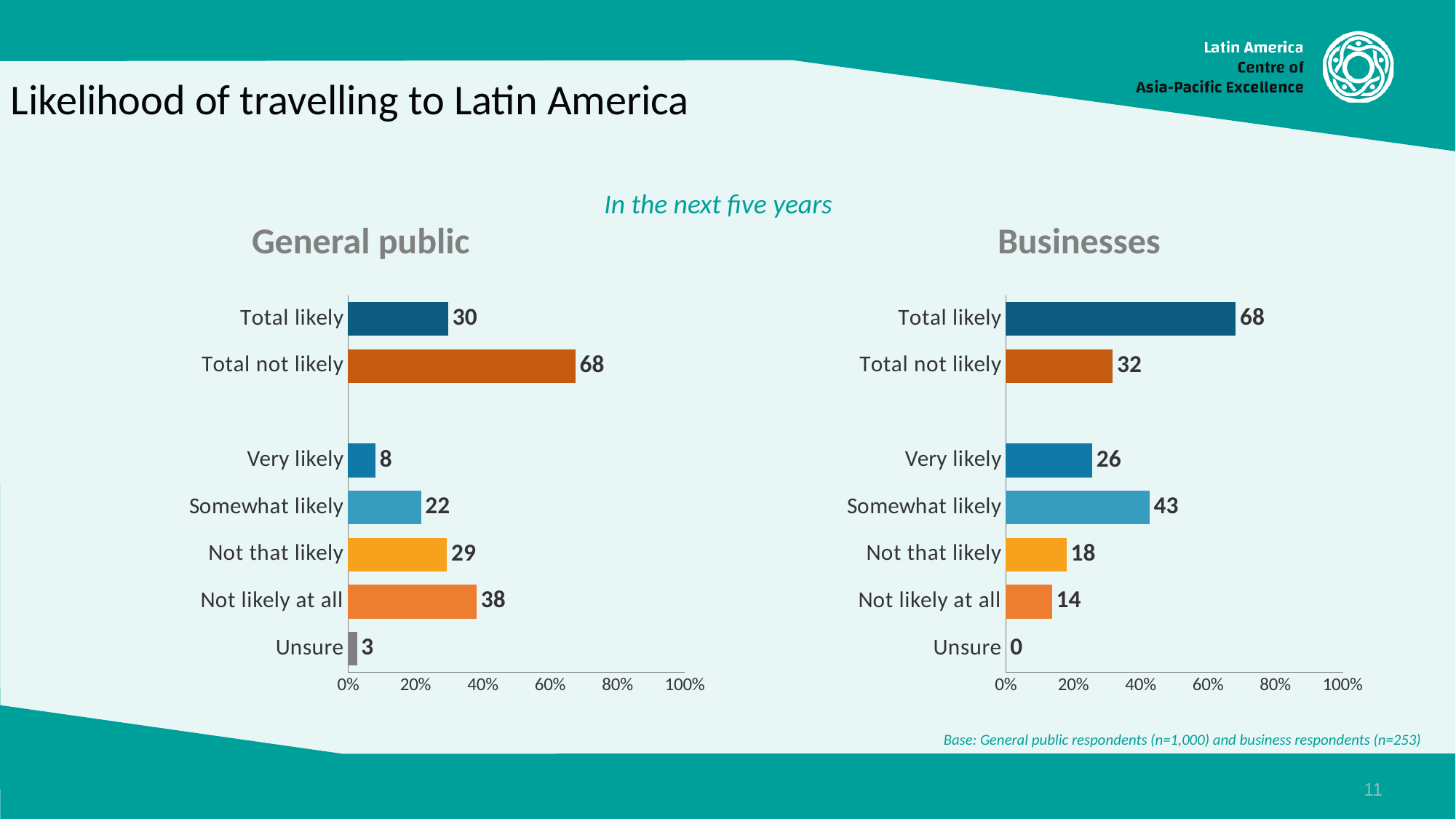
In the General public chart, what is the value for Unsure? 3 What kind of chart is the Businesses chart? Bar chart What is the subtitle shown above the two charts? In the next five years In the Businesses chart, what is the value for Somewhat likely? 43 In the Businesses chart, which category has the highest value? Total likely Which is larger: Very likely in the General public chart or Very likely in the Businesses chart? Businesses In the General public chart, which category has the lowest value? Unsure In the Businesses chart, what is the difference between Total likely and Total not likely? 36 In the Businesses chart, what is the value for Not likely at all? 14 In the General public chart, what is the difference between Not likely at all and Not that likely? 9 How many categories are shown in the General public chart? 7 In the General public chart, what is the value for Total not likely? 68